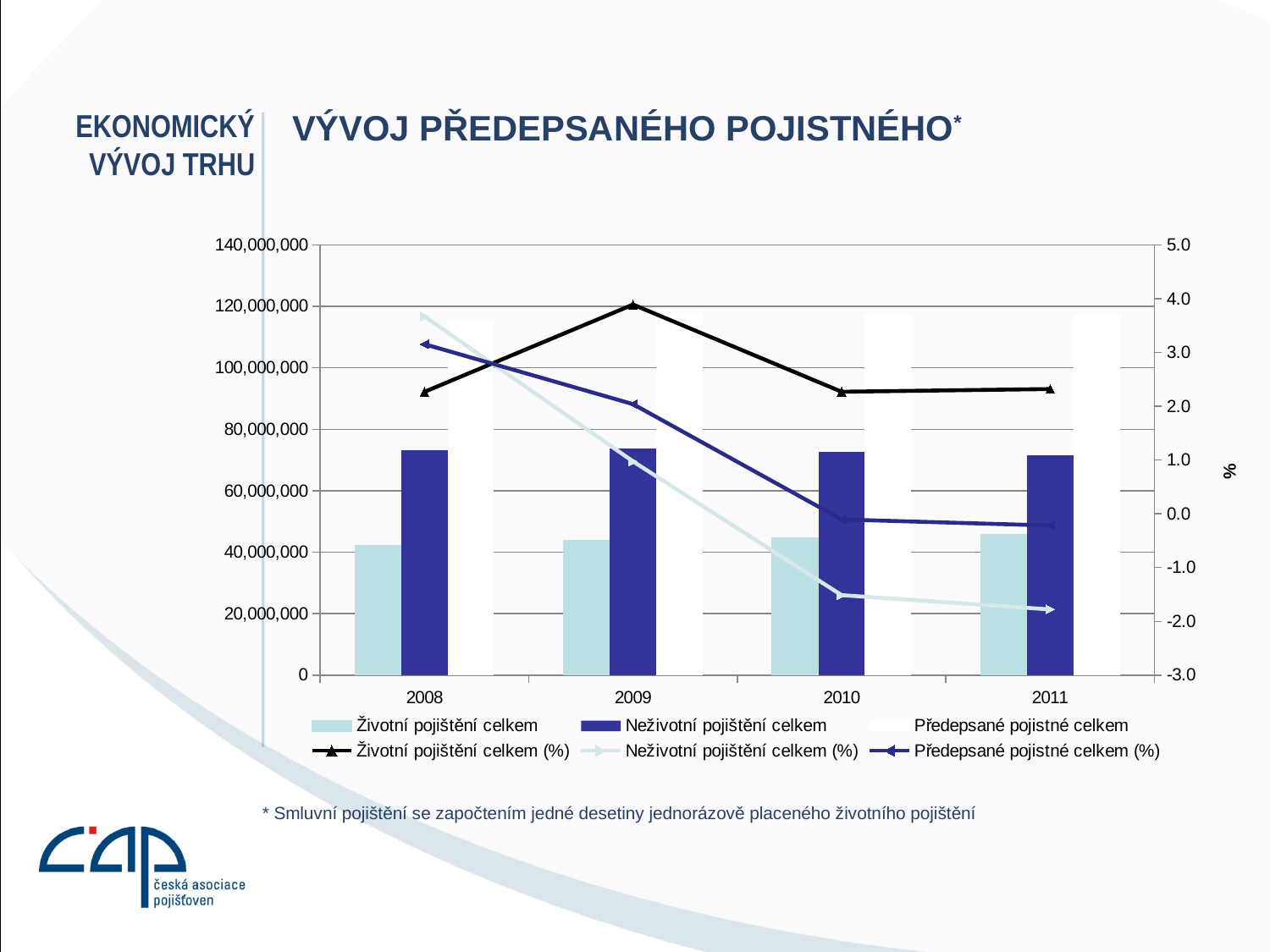
Is the value of the Neživotní pojištění celkem bar for 2009 greater or less than 60,000,000? greater Is the value of the Neživotní pojištění celkem (%) line for 2011 greater or less than -1.0? less In which year does the Životní pojištění celkem (%) line reach its highest value? 2009 What is the title of the chart? VÝVOJ PŘEDEPSANÉHO POJISTNÉHO* In 2010, which bar is taller: Životní pojištění celkem or Neživotní pojištění celkem? Neživotní pojištění celkem How many series does the chart legend list? 6 What kind of chart is shown on the slide? A combined bar and line chart Is the value of the Životní pojištění celkem bar for 2008 greater or less than 60,000,000? less What is the label of the right-hand vertical axis? % How many years are shown on the x axis of the chart? 4 Does the Neživotní pojištění celkem (%) line rise or fall from 2008 to 2011? It falls